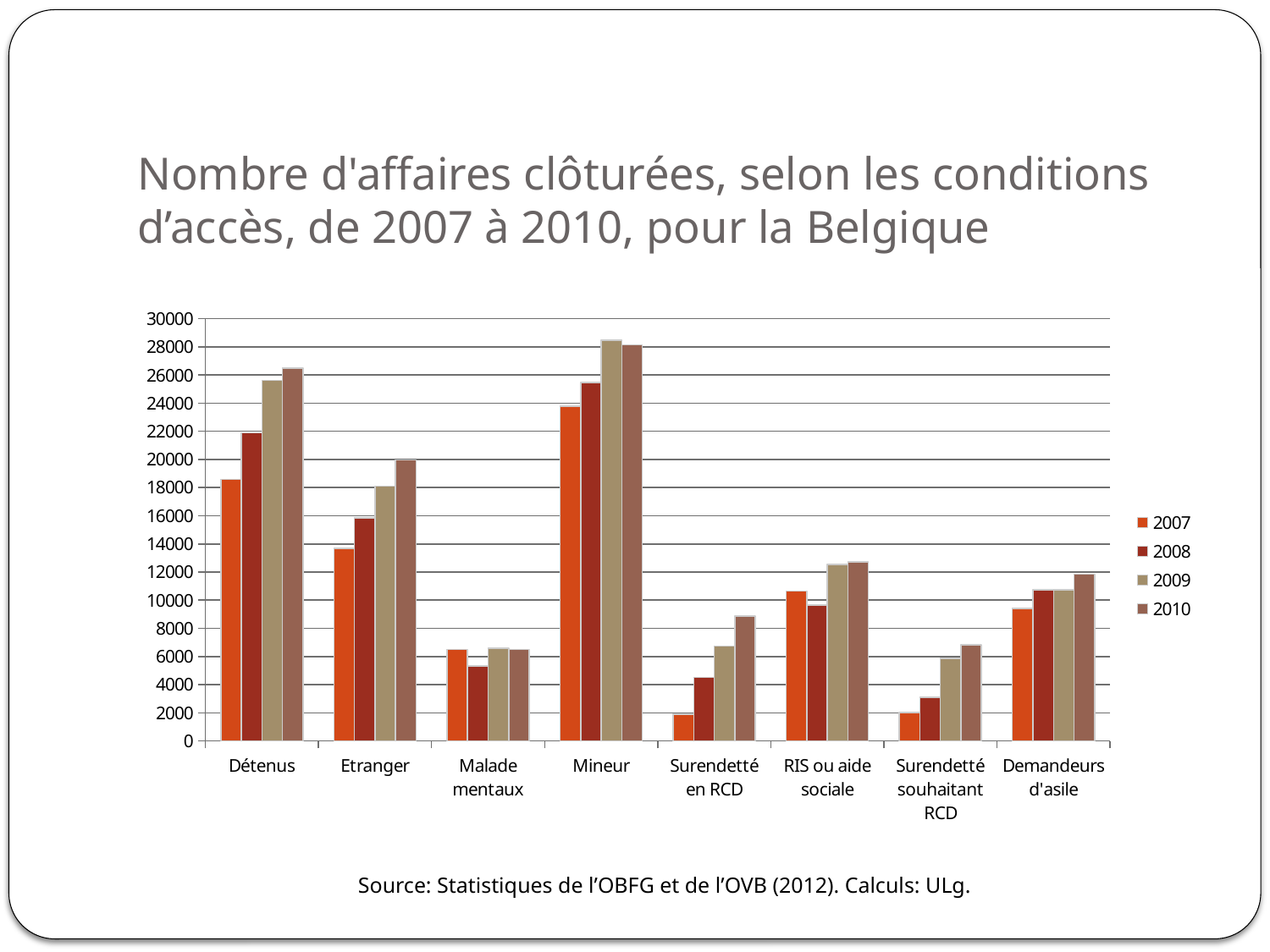
How many series does the legend list? 4 Which is larger for 2010: Détenus or Mineur? Mineur Which category has the lowest value for 2008? Surendetté souhaitant RCD Is the value for Etranger in 2007 greater or less than 14000? less Do the values for Détenus rise or fall from 2007 to 2010? rise What kind of chart is shown on the slide? bar chart How many categories are shown on the x axis of the chart? 8 Is the value for Demandeurs d'asile in 2007 greater or less than 10000? less Is the value for Surendetté en RCD in 2010 greater or less than 8000? greater Which year does the lightest (beige) bar colour represent in the legend? 2009 Which category has the highest values in the chart? Mineur